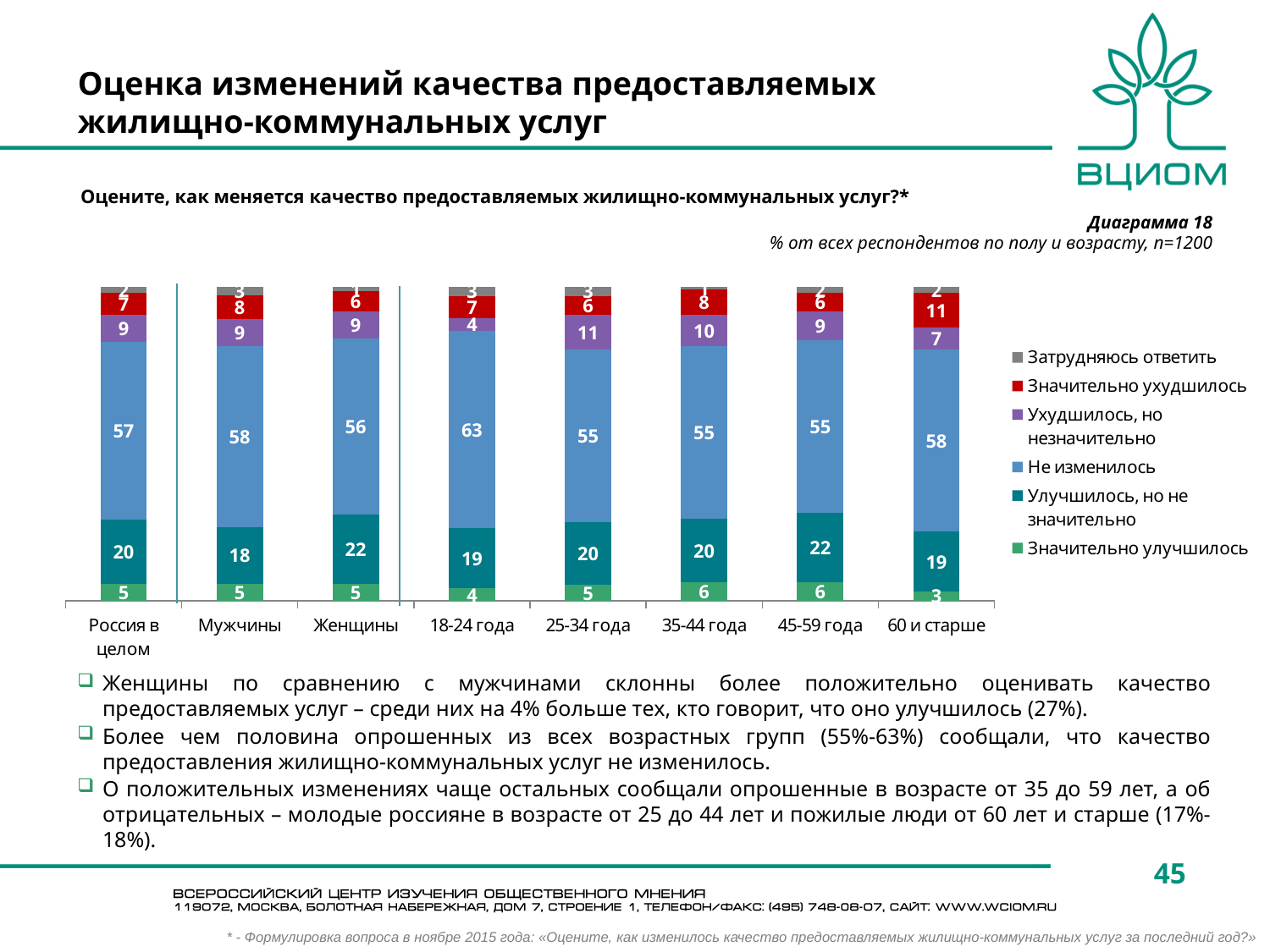
What is the difference between the "Улучшилось, но не значительно" values for "Женщины" and "Мужчины"? 4 What is the value of "Не изменилось" for "18-24 года"? 63 Which category has the highest value for "Не изменилось"? 18-24 года What is the value of "Улучшилось, но не значительно" for "Женщины"? 22 What is the value of "Значительно ухудшилось" for "60 и старше"? 11 Which is larger: the "Ухудшилось, но незначительно" value for "25-34 года" or for "18-24 года"? 25-34 года Which category has the lowest value for "Значительно улучшилось"? 60 и старше What type of chart is shown on the slide? Stacked bar chart How many series does the legend list? 6 What is the total of the stacked bar for "Россия в целом"? 100 How many categories are shown along the x axis of the chart? 8 Which series is shown in red in the chart? Значительно ухудшилось